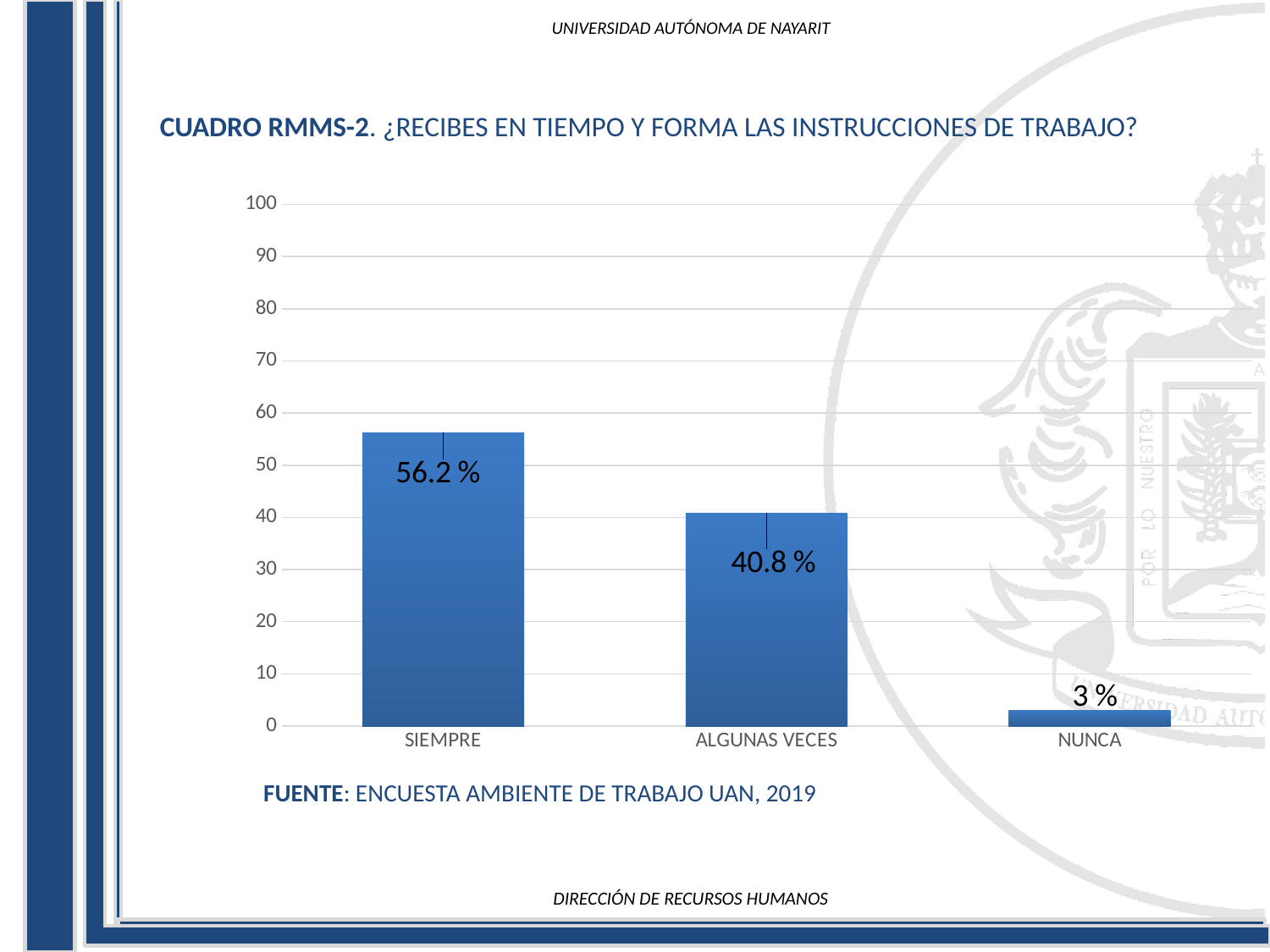
Which category has the highest value? SIEMPRE What is the value for ALGUNAS VECES? 40.8 % Is the value for ALGUNAS VECES greater or less than 50? less Do the values rise or fall from left to right along the x axis? fall Which category has the lowest value? NUNCA What is the difference between the values for ALGUNAS VECES and NUNCA? 37.8 % What is the value for NUNCA? 3 % What kind of chart is shown on the slide? bar chart What is the value for SIEMPRE? 56.2 % How many categories are shown on the x axis? 3 Which is larger, the value for SIEMPRE or the value for ALGUNAS VECES? SIEMPRE What is the difference between the values for SIEMPRE and ALGUNAS VECES? 15.4 %